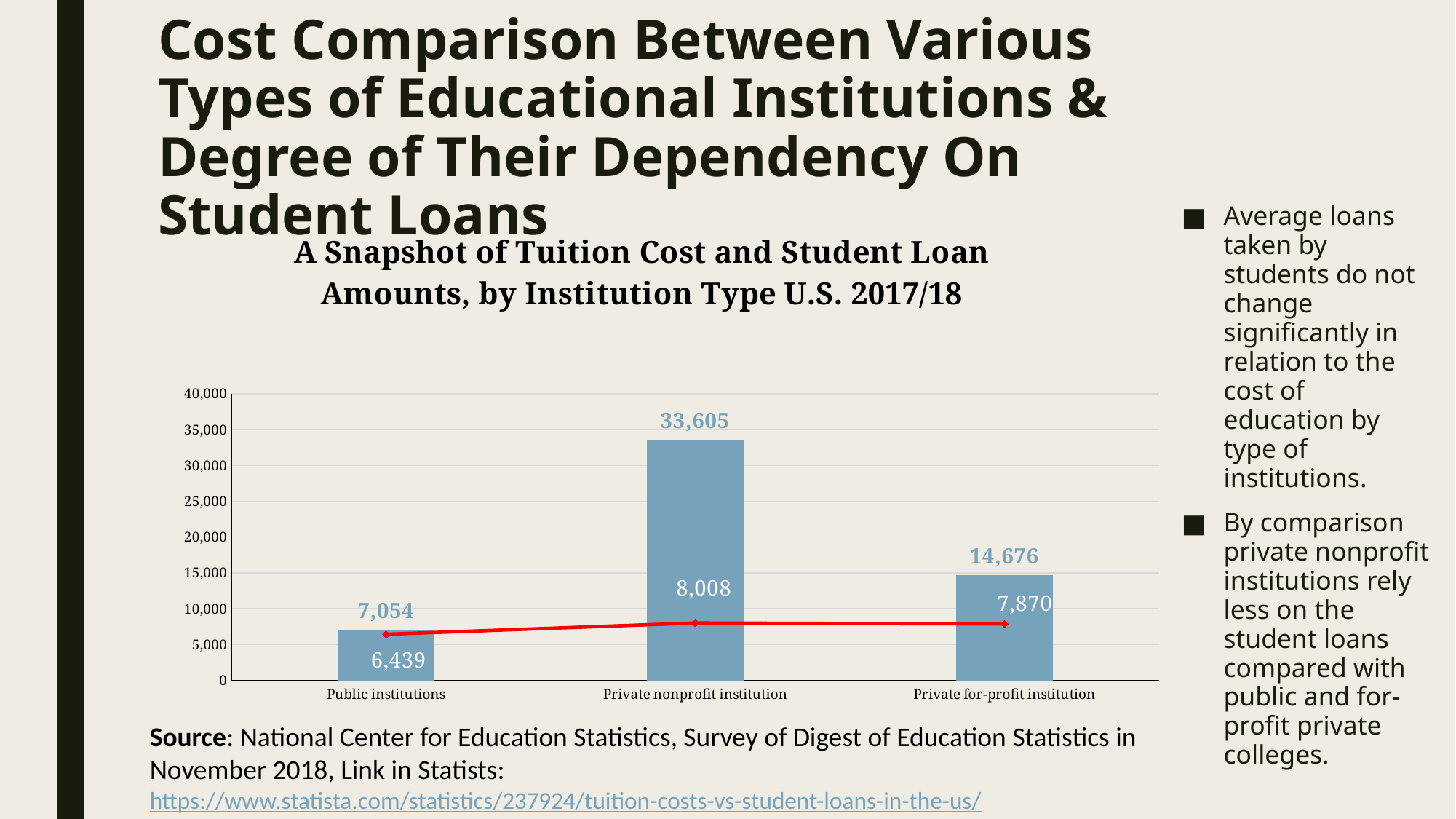
What is the bar value for Private for-profit institution? 14,676 What is the difference between the bar values for Private nonprofit institution and Private for-profit institution? 18,929 What is the title of the chart? A Snapshot of Tuition Cost and Student Loan Amounts, by Institution Type U.S. 2017/18 What is the bar value for Public institutions? 7,054 How many institution types are shown on the x axis? 3 What is the red line value for Private for-profit institution? 7,870 Which institution type has the highest bar value? Private nonprofit institution Which is larger, the bar value for Private for-profit institution or the bar value for Public institutions? Private for-profit institution What is the bar value for Private nonprofit institution? 33,605 Which institution type has the lowest bar value? Public institutions What is the red line value for Private nonprofit institution? 8,008 What is the red line value for Public institutions? 6,439